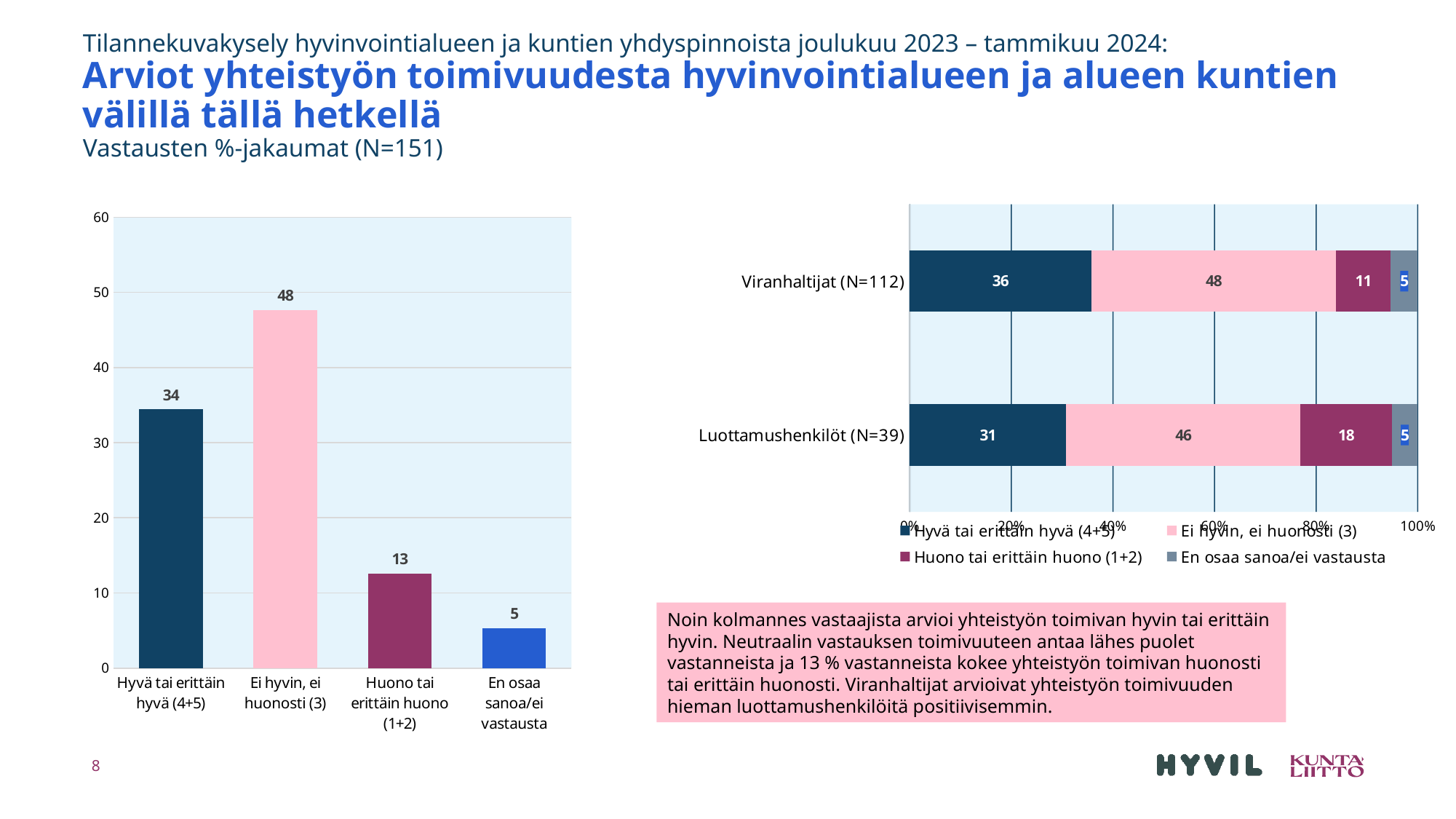
In the left bar chart, what is the difference between the values for "Ei hyvin, ei huonosti (3)" and "Hyvä tai erittäin hyvä (4+5)"? 14 How many series does the legend of the right stacked bar chart list? 4 In the right stacked bar chart, which group has the larger value for "Huono tai erittäin huono (1+2)": Viranhaltijat (N=112) or Luottamushenkilöt (N=39)? Luottamushenkilöt (N=39) In the right stacked bar chart, what is the value of "Huono tai erittäin huono (1+2)" for Luottamushenkilöt (N=39)? 18 In the left bar chart, which category has the highest value? Ei hyvin, ei huonosti (3) What kind of chart is the chart on the left of the slide? Bar chart In the right stacked bar chart, what is the total of the segments in the Viranhaltijat (N=112) bar? 100 In the right stacked bar chart, what is the difference between the "Ei hyvin, ei huonosti (3)" values for Viranhaltijat (N=112) and Luottamushenkilöt (N=39)? 2 In the right stacked bar chart, what is the value of "Hyvä tai erittäin hyvä (4+5)" for Viranhaltijat (N=112)? 36 In the left bar chart, what is the value for "Ei hyvin, ei huonosti (3)"? 48 In the left bar chart, how many categories are shown on the x axis? 4 In the left bar chart, which category has the lowest value? En osaa sanoa/ei vastausta